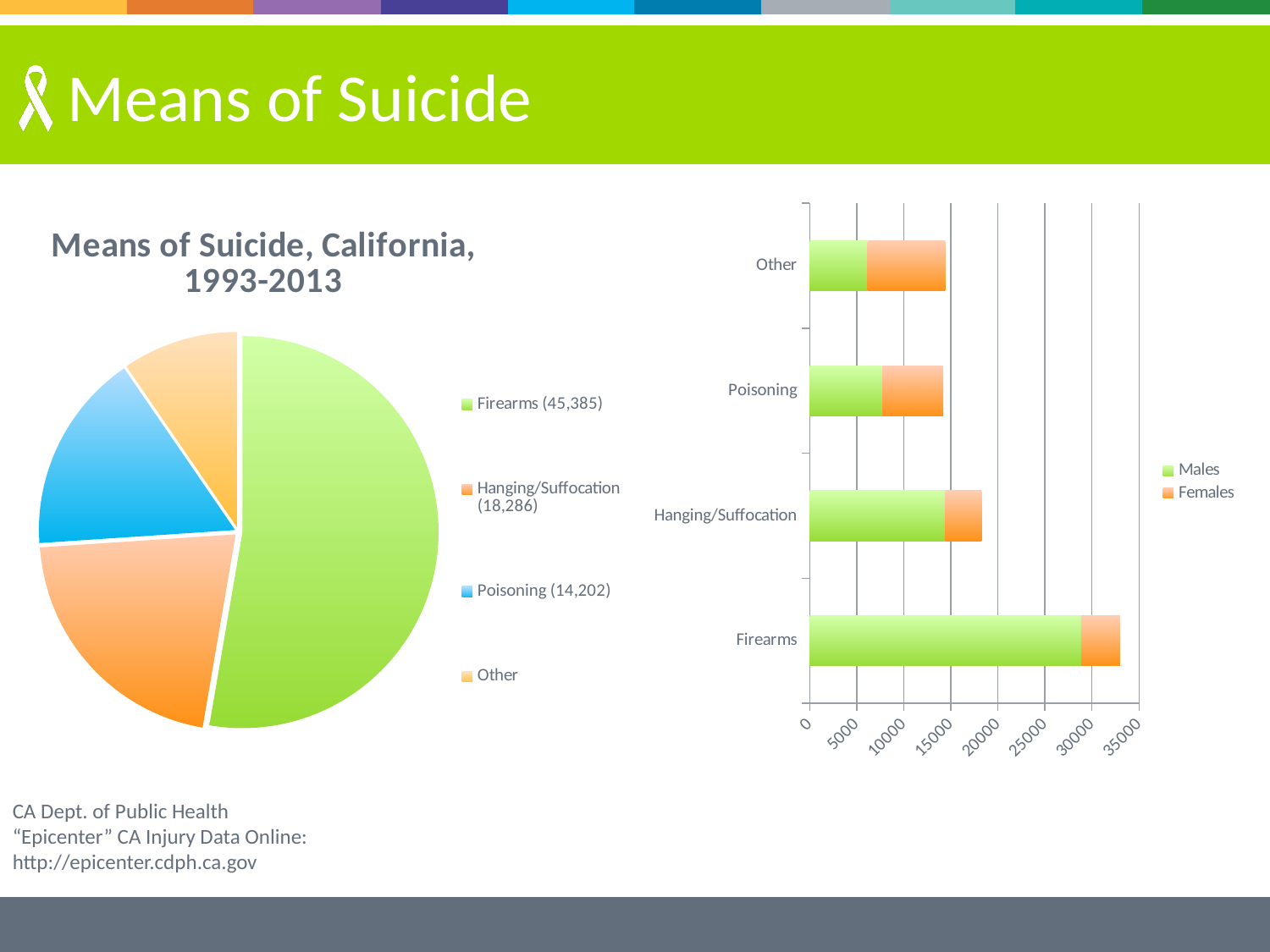
On the pie chart titled "Means of Suicide, California, 1993-2013", what value is shown for Hanging/Suffocation? 18,286 On the bar chart on the right side of the slide, is the Males value for Firearms greater or less than 25000? greater On the pie chart titled "Means of Suicide, California, 1993-2013", what value is shown for Poisoning? 14,202 On the pie chart titled "Means of Suicide, California, 1993-2013", what is the difference between the Firearms value and the Hanging/Suffocation value? 27,099 What kind of chart is the chart on the right side of the slide? Bar chart On the pie chart titled "Means of Suicide, California, 1993-2013", what value is shown for Firearms? 45,385 On the bar chart on the right side of the slide, which category has the longest bar? Firearms On the pie chart titled "Means of Suicide, California, 1993-2013", how many slices does the pie have? 4 On the bar chart on the right side of the slide, is the Females value for Firearms greater or less than 5000? less On the pie chart titled "Means of Suicide, California, 1993-2013", which means of suicide has the largest slice? Firearms On the bar chart on the right side of the slide, which is larger, the total bar for Firearms or the total bar for Hanging/Suffocation? Firearms On the bar chart on the right side of the slide, how many series does the legend list? 2